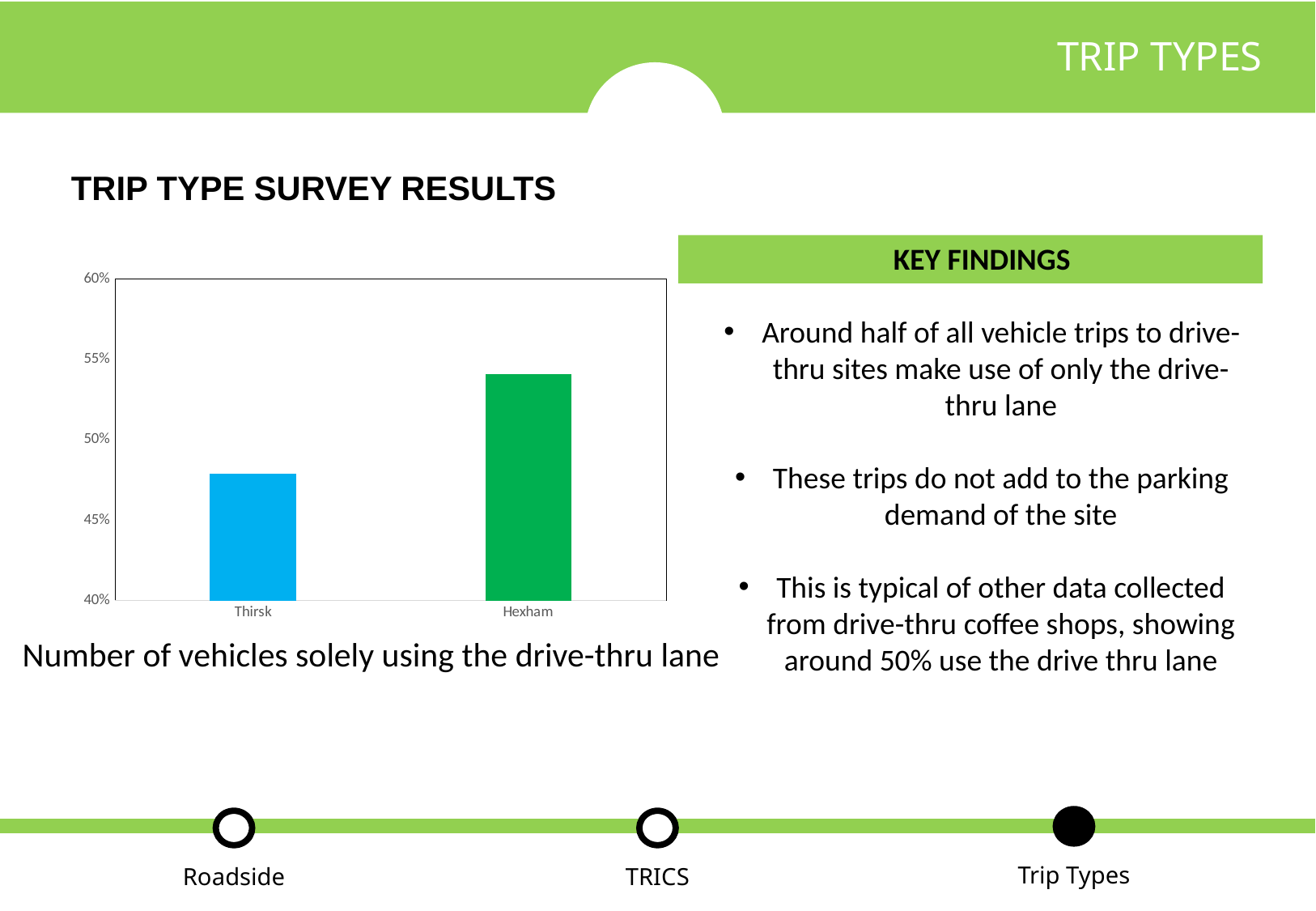
Is the value for Thirsk greater or less than 50%? less Which is larger, the value for Thirsk or the value for Hexham? Hexham What is the lowest value shown on the chart's vertical axis? 40% Is the value for Hexham greater or less than 55%? less Which category has the lowest value on the chart? Thirsk Is the value for Thirsk greater or less than 45%? greater How many categories are plotted on the chart? 2 What kind of chart is shown on the slide? bar chart What caption appears below the chart? Number of vehicles solely using the drive-thru lane Which category has the highest value on the chart? Hexham